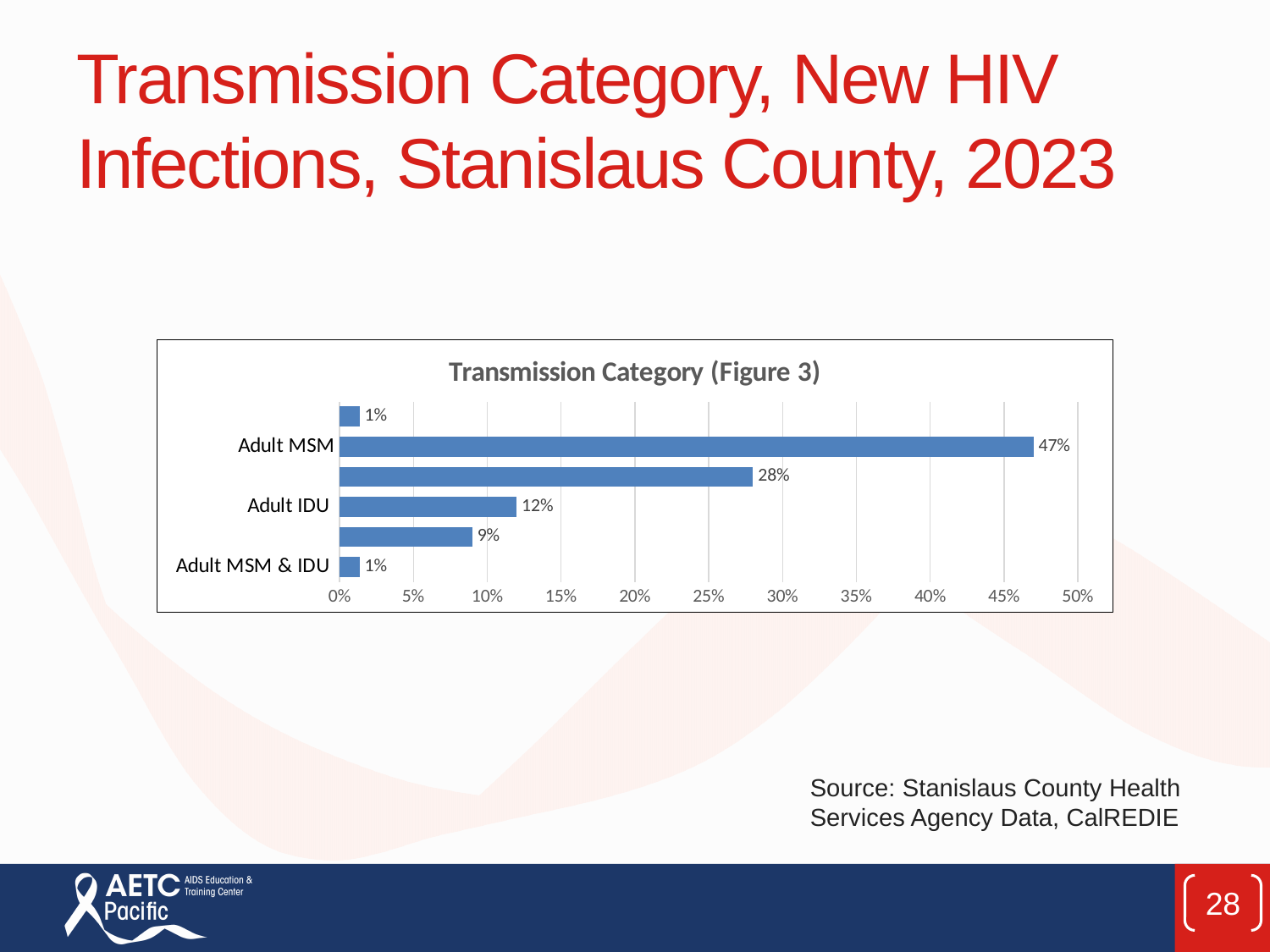
Is the value for Adult MSM greater or less than 45%? greater What is the value for Adult MSM? 47% Which labelled category has the highest value? Adult MSM What is the difference between the values for Adult MSM and Adult IDU? 35% What is the value for Adult MSM & IDU? 1% What is the title of the chart? Transmission Category (Figure 3) Which is larger, the value for Adult MSM or the value for Adult IDU? Adult MSM What is the value for Adult IDU? 12% What is the difference between the values for Adult IDU and Adult MSM & IDU? 11% What is the highest value shown on the chart? 47% What kind of chart is shown on the slide? bar chart How many bars are plotted on the chart? 6